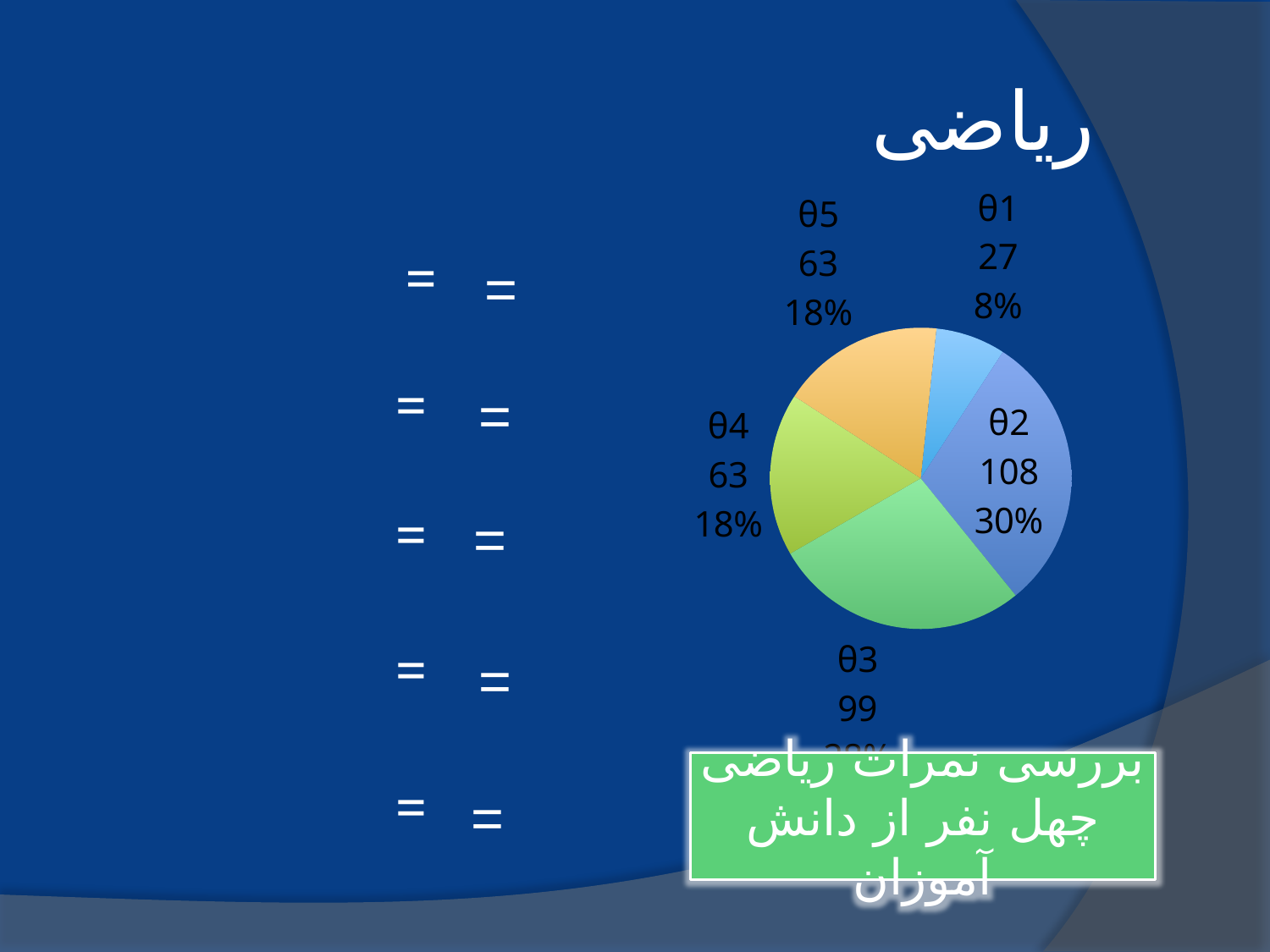
What is the value shown for θ2 in the pie chart? 108 What percentage share does θ1 have in the pie chart? 8% What is the value shown for θ3 in the pie chart? 99 What is the difference between the values for θ2 and θ3? 9 How many slices does the pie chart have? 5 Which category has the smallest slice in the pie chart? θ1 What is the value shown for θ1 in the pie chart? 27 What is the title of the chart? ریاضی Which is larger, the value for θ3 or the value for θ4? θ3 What kind of chart is shown on the slide? pie chart Which category has the largest slice in the pie chart? θ2 What percentage share does θ5 have in the pie chart? 18%